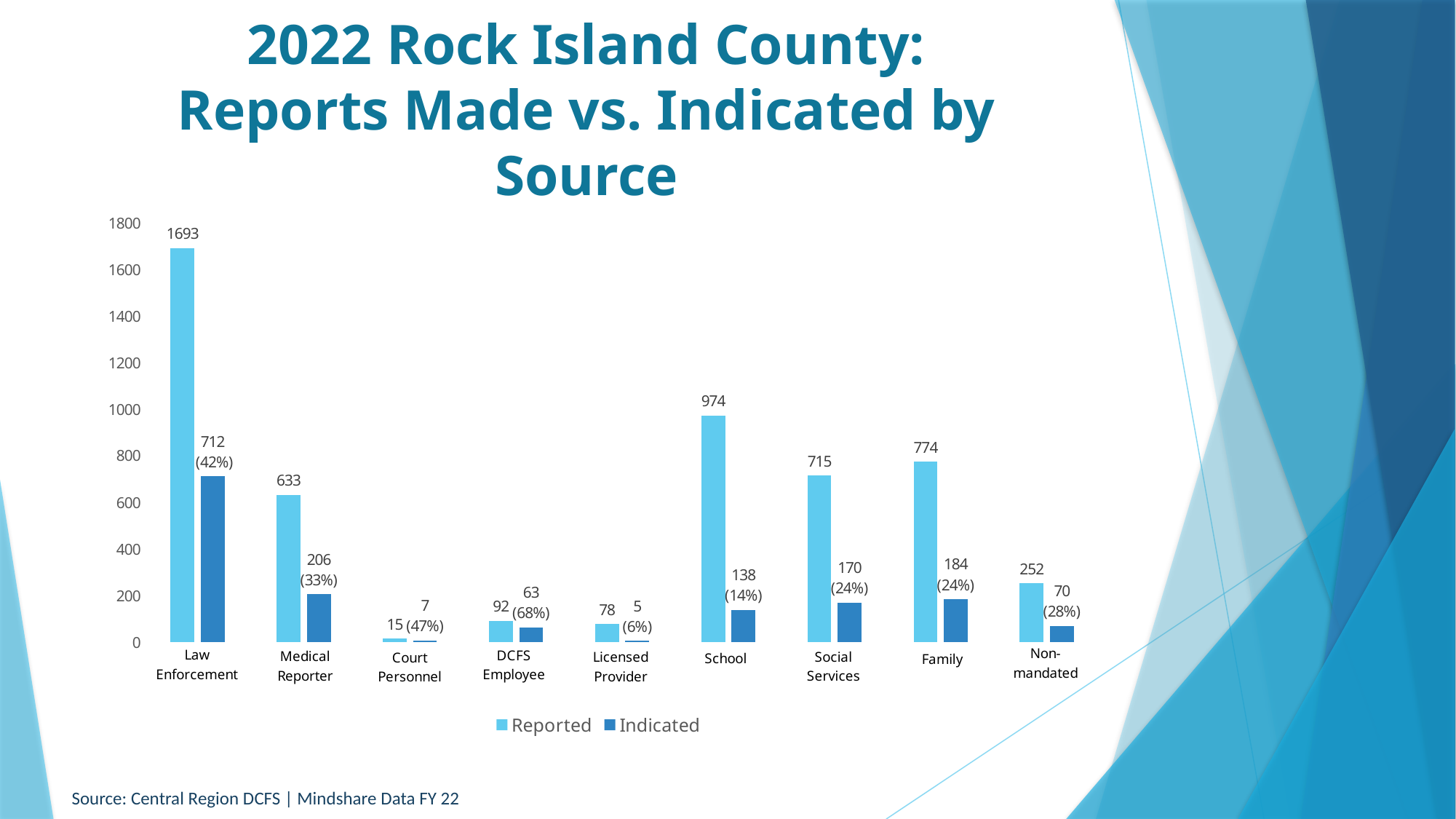
What is the Indicated value for School? 138 Which source has the lowest Indicated value? Licensed Provider How many series does the legend list? 2 Is the Reported value for School greater or less than 1000? less What is the Reported value for Law Enforcement? 1693 Which source has the highest Reported value? Law Enforcement What percentage is shown next to the Indicated value for DCFS Employee? 68% How many sources are shown on the x axis? 9 What is the difference between the Reported and Indicated values for Medical Reporter? 427 Which is larger, the Reported value for Family or the Reported value for Social Services? Family What kind of chart is shown on the slide? bar chart What is the Reported value for Social Services? 715